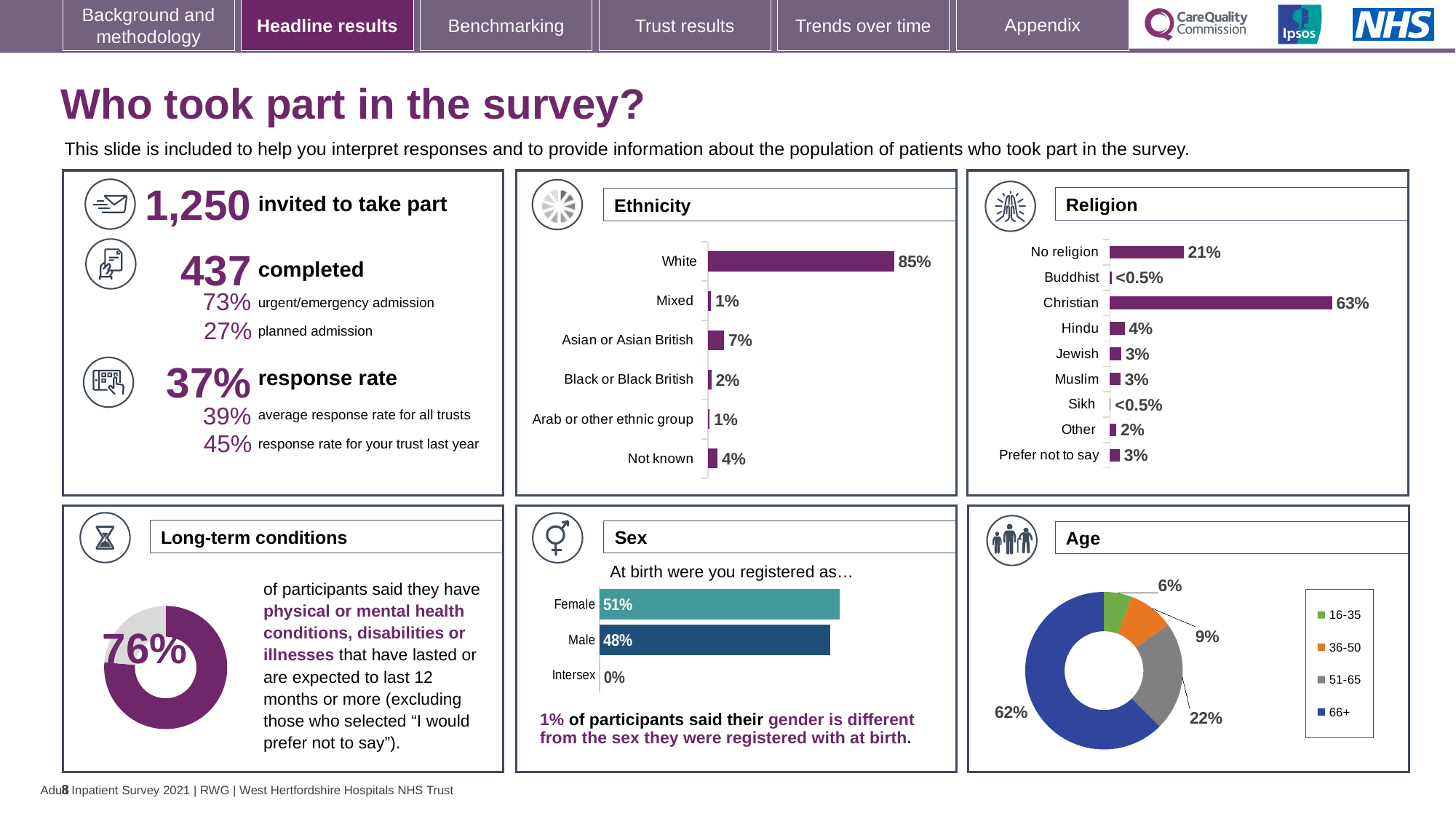
In the Sex chart, what percentage of participants were registered as Female at birth? 51% In the Religion chart, how many categories are listed? 9 What kind of chart is used for the Age breakdown? Doughnut chart In the Ethnicity chart, how many ethnicity categories are shown? 6 In the Ethnicity chart, what percentage of participants were White? 85% In the Age chart, what share of participants were aged 66+? 62% In the Age chart, how many age groups does the legend list? 4 In the Sex chart, which is larger, the Female or the Male percentage? Female In the Ethnicity chart, which ethnic group has the lowest share apart from the two at 1%? Black or Black British In the Religion chart, which religion category has the highest value? Christian In the Religion chart, what is the difference between the Christian and No religion percentages? 42 percentage points In the Religion chart, what percentage of participants were Christian? 63%